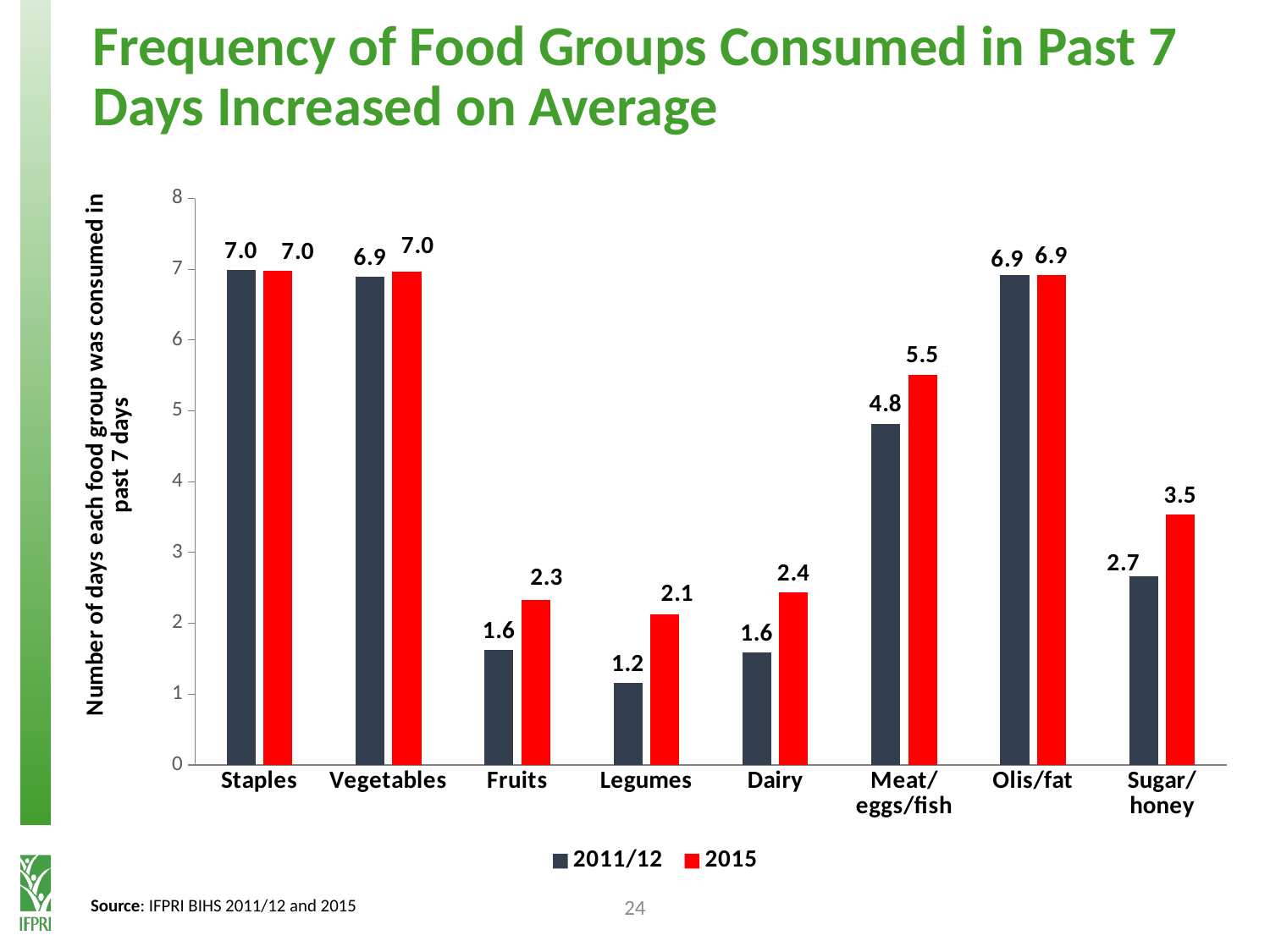
What was the value for Sugar/honey in 2015? 3.5 Which food group had the lowest value in 2011/12? Legumes What was the value for Fruits in 2015? 2.3 How many series does the legend list? 2 What is the difference between the 2015 and 2011/12 values for Legumes? 0.9 What was the value for Meat/eggs/fish in 2011/12? 4.8 Which is larger: the 2015 value for Dairy or the 2015 value for Fruits? Dairy What kind of chart is shown on the slide? bar chart What is the difference between the 2015 and 2011/12 values for Sugar/honey? 0.8 How many food groups are shown on the x axis? 8 Is the 2011/12 value for Meat/eggs/fish greater or less than 5? less Which food group had the lowest value in 2015? Legumes